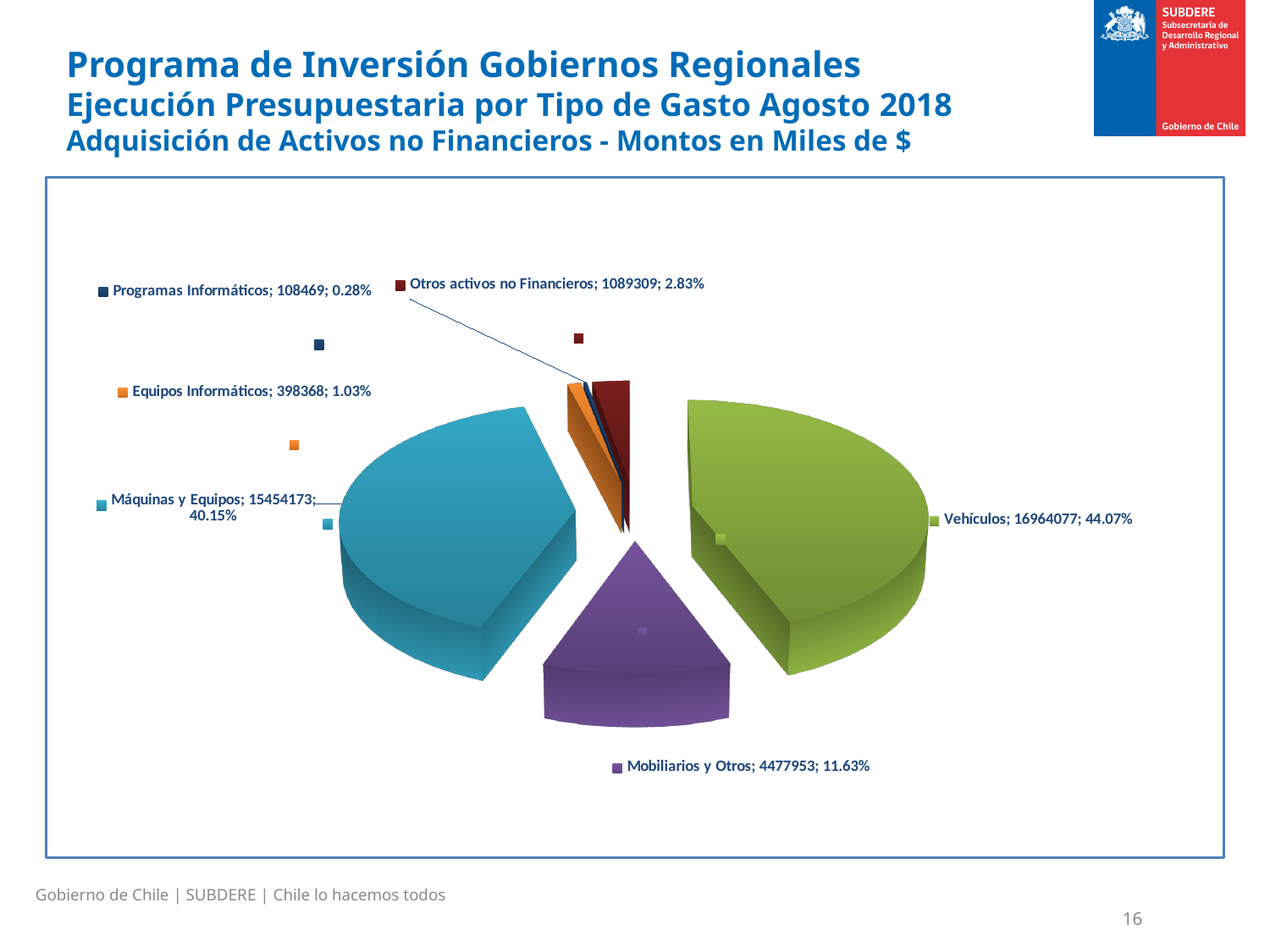
What is the value for Máquinas y Equipos? 15454173 What is the value for Otros activos no Financieros? 1089309 How many categories (slices) does the pie chart show? 6 What is the difference between the values for Vehículos and Máquinas y Equipos? 1509904 Which category has the largest slice of the pie? Vehículos Which is larger, the value for Mobiliarios y Otros or the value for Otros activos no Financieros? Mobiliarios y Otros What is the value for Vehículos? 16964077 What share of the pie does Programas Informáticos represent? 0.28% Which category has the smallest slice of the pie? Programas Informáticos What is the value for Mobiliarios y Otros? 4477953 What share of the pie does Equipos Informáticos represent? 1.03% What kind of chart is shown on the slide? pie chart